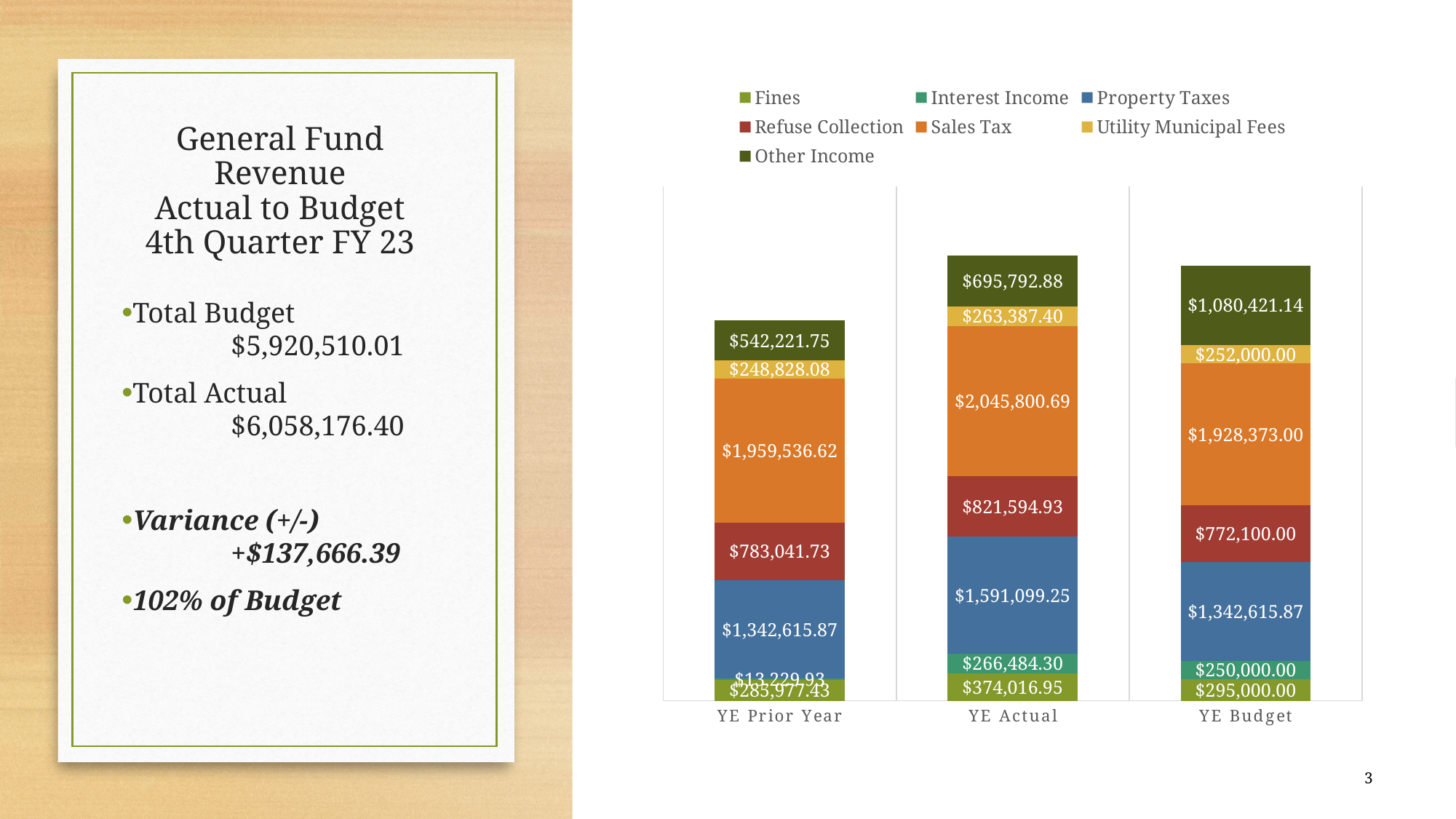
Is the Sales Tax value larger for YE Actual or YE Budget? YE Actual What is the Sales Tax value for YE Actual? $2,045,800.69 What kind of chart is shown on the slide? Stacked bar chart What is the total of the YE Actual stacked bar? $6,058,176.40 What is the difference between the Sales Tax values for YE Actual and YE Budget? $117,427.69 What is the Fines value for YE Actual? $374,016.95 How many categories are shown on the x axis of the chart? 3 What is the Property Taxes value for YE Budget? $1,342,615.87 How many series does the chart legend list? 7 What is the Other Income value for YE Prior Year? $542,221.75 Which category has the highest Other Income value? YE Budget Which category has the lowest Refuse Collection value? YE Budget